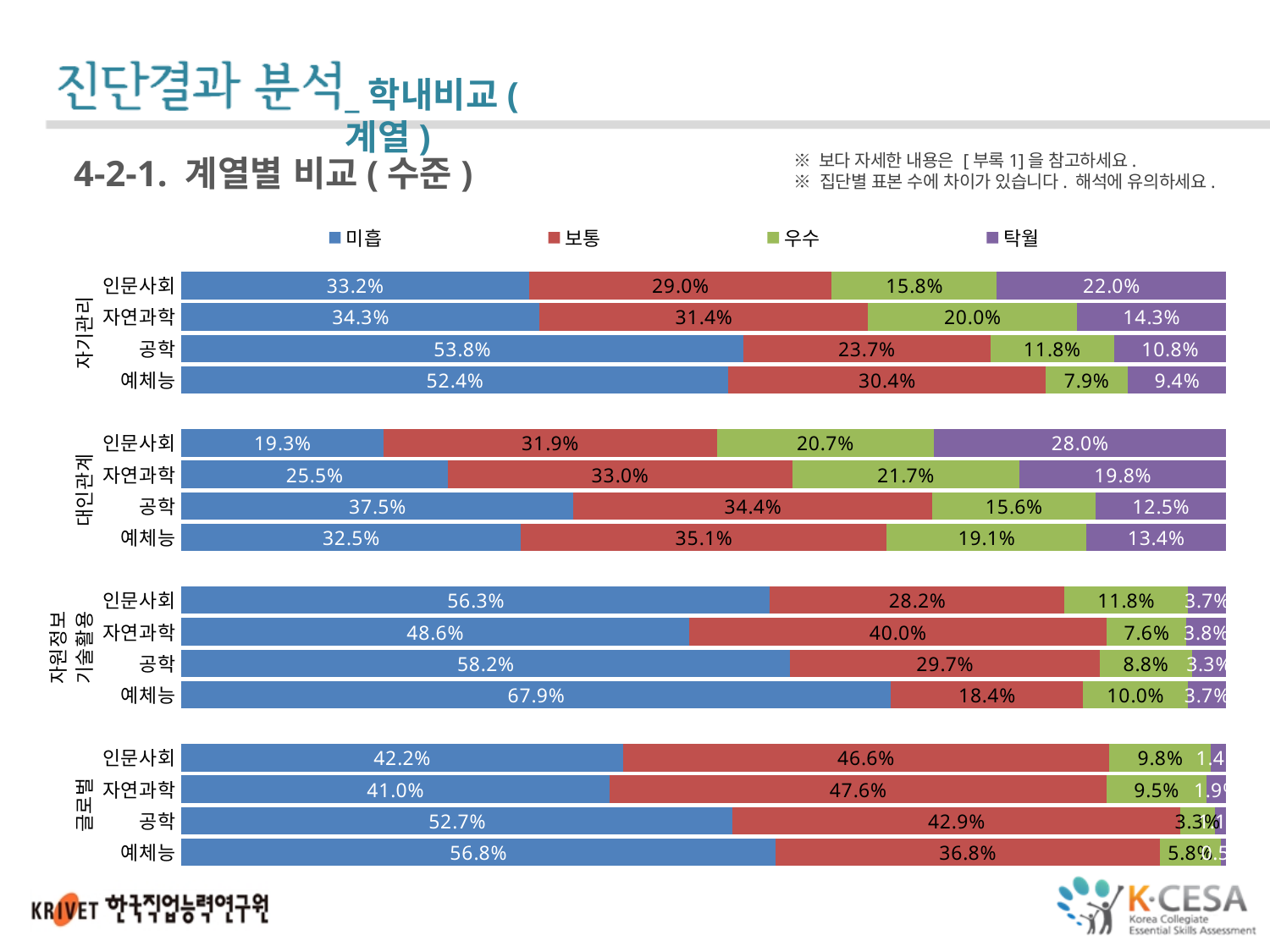
In the 글로벌 group, which has the larger 보통 value, 인문사회 or 자연과학? 자연과학 How many categories are shown within each group (e.g., 자기관리)? 4 In the 자기관리 group, what is the difference between the 탁월 values for 인문사회 and 자연과학? 7.7% In the 자기관리 group, which category has the highest 미흡 value? 공학 What are the four legend entries of the chart? 미흡, 보통, 우수, 탁월 In the 자기관리 group, what is the 미흡 value for 인문사회? 33.2% What kind of chart is shown on the slide? Stacked bar chart In the 대인관계 group, what is the 보통 value for 공학? 34.4% In the 자원정보기술활용 group, what is the 미흡 value for 예체능? 67.9% In the 글로벌 group, what is the 미흡 value for 공학? 52.7% How many series does the legend list? 4 In the 대인관계 group, which category has the lowest 미흡 value? 인문사회